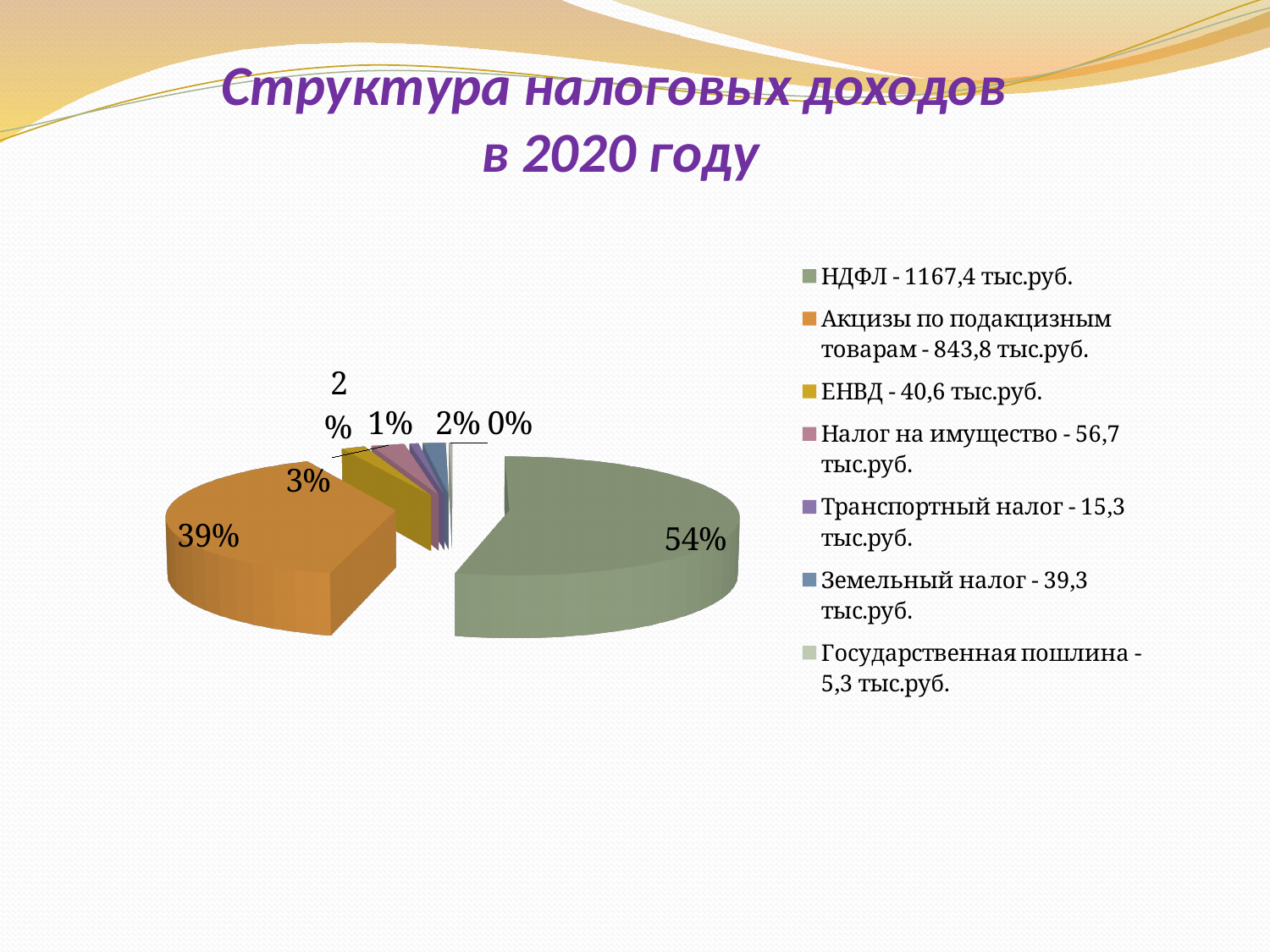
Which category has the smallest share of the pie? Государственная пошлина Which category has the largest share of the pie? НДФЛ What is the title of the slide? Структура налоговых доходов в 2020 году How many categories does the pie chart show? 7 What kind of chart is shown on the slide? Pie chart What is the difference between the values for НДФЛ and Акцизы по подакцизным товарам? 323,6 тыс.руб. What share of the pie does НДФЛ account for? 54% What is the value for Транспортный налог according to the legend? 15,3 тыс.руб. What share of the pie does Акцизы по подакцизным товарам account for? 39% What is the value for НДФЛ according to the legend? 1167,4 тыс.руб. What is the value for Акцизы по подакцизным товарам according to the legend? 843,8 тыс.руб. Which is larger, the value for ЕНВД or the value for Земельный налог? ЕНВД